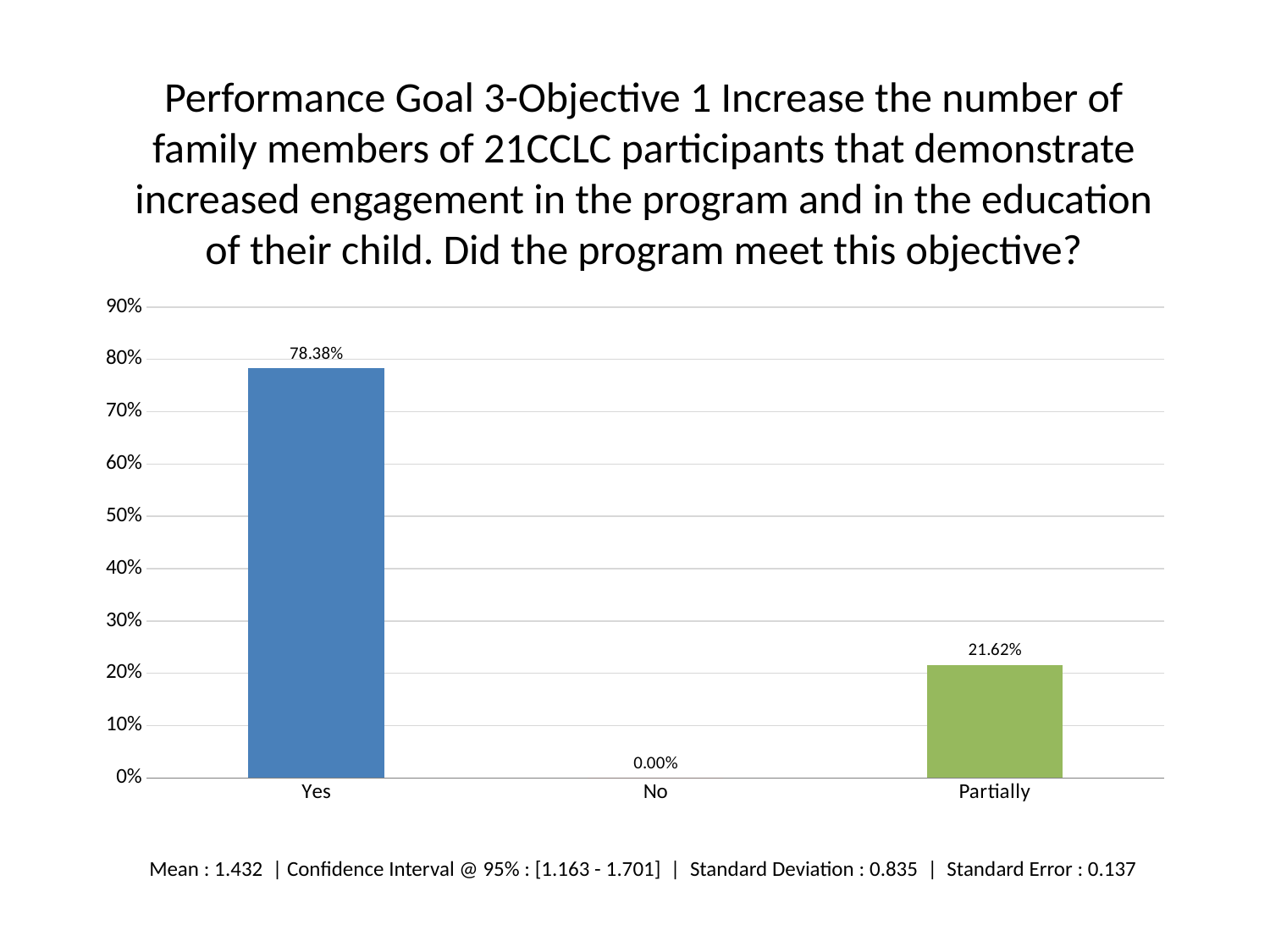
How many categories are shown on the x axis? 3 What is the mean reported below the chart? 1.432 Which is larger, the value for Yes or the value for Partially? Yes What is the value for No? 0.00% What is the value for Yes? 78.38% What is the value for Partially? 21.62% Is the value for Yes greater or less than 70%? greater Which category has the highest value? Yes Which category has the lowest value? No What kind of chart is shown on the slide? bar chart What is the difference between the values for Yes and Partially? 56.76% Is the value for Partially greater or less than 30%? less